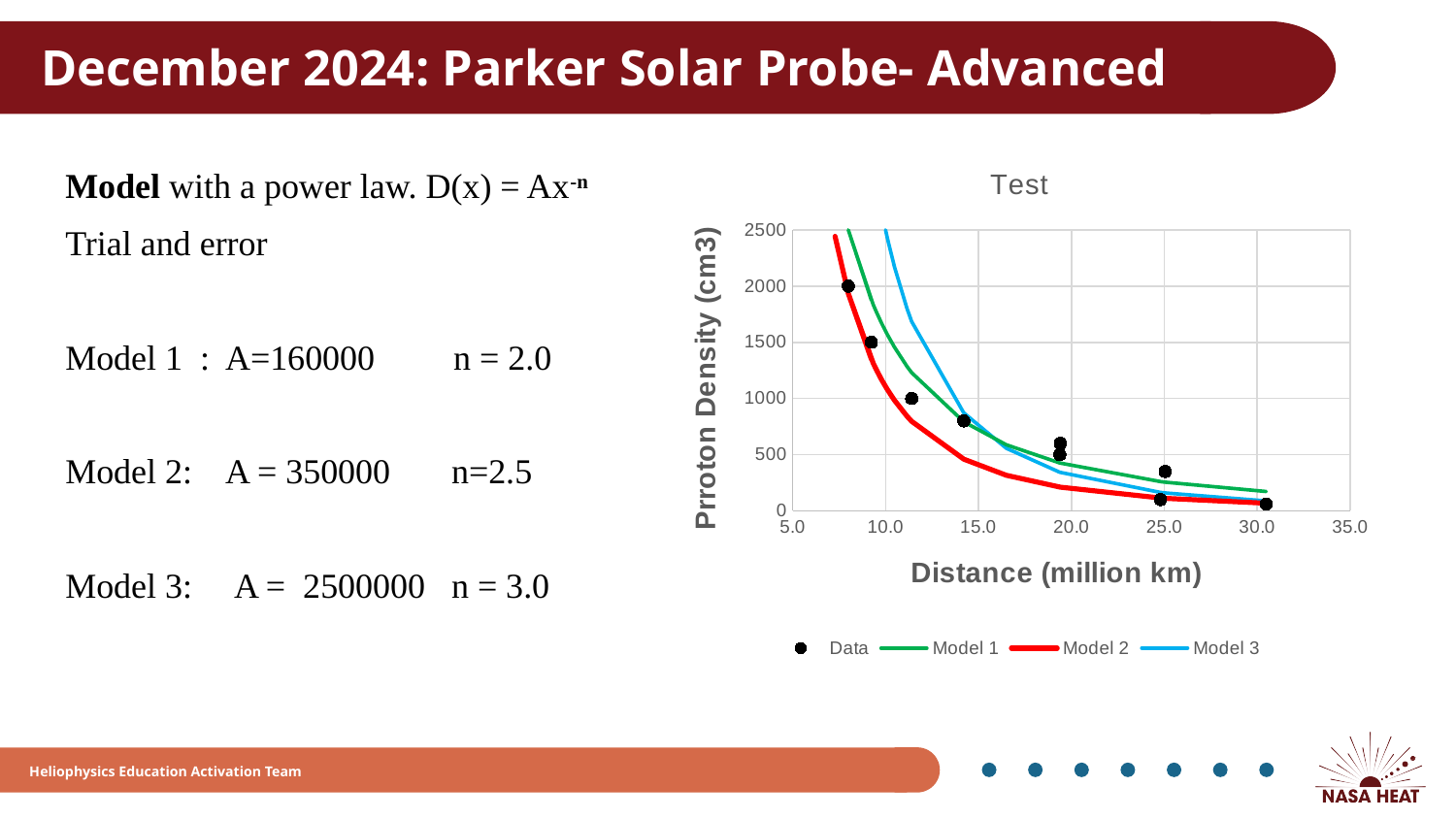
Is the Model 3 value at a distance of 10.0 million km greater or less than 2000? greater Do the Data values rise or fall as distance increases along the x axis? fall What kind of chart is shown on the slide? line chart How many series does the chart legend list? 4 What is the x-axis title of the chart? Distance (million km) At a distance of 10.0 million km, which is larger: the Model 3 value or the Model 2 value? Model 3 Is the Data value at the largest distance (around 30 million km) greater or less than 500? less What is the highest value shown on the y axis of the chart? 2500 Is the Data value at the smallest distance (around 8 million km) greater or less than 1500? greater What is the title of the chart? Test